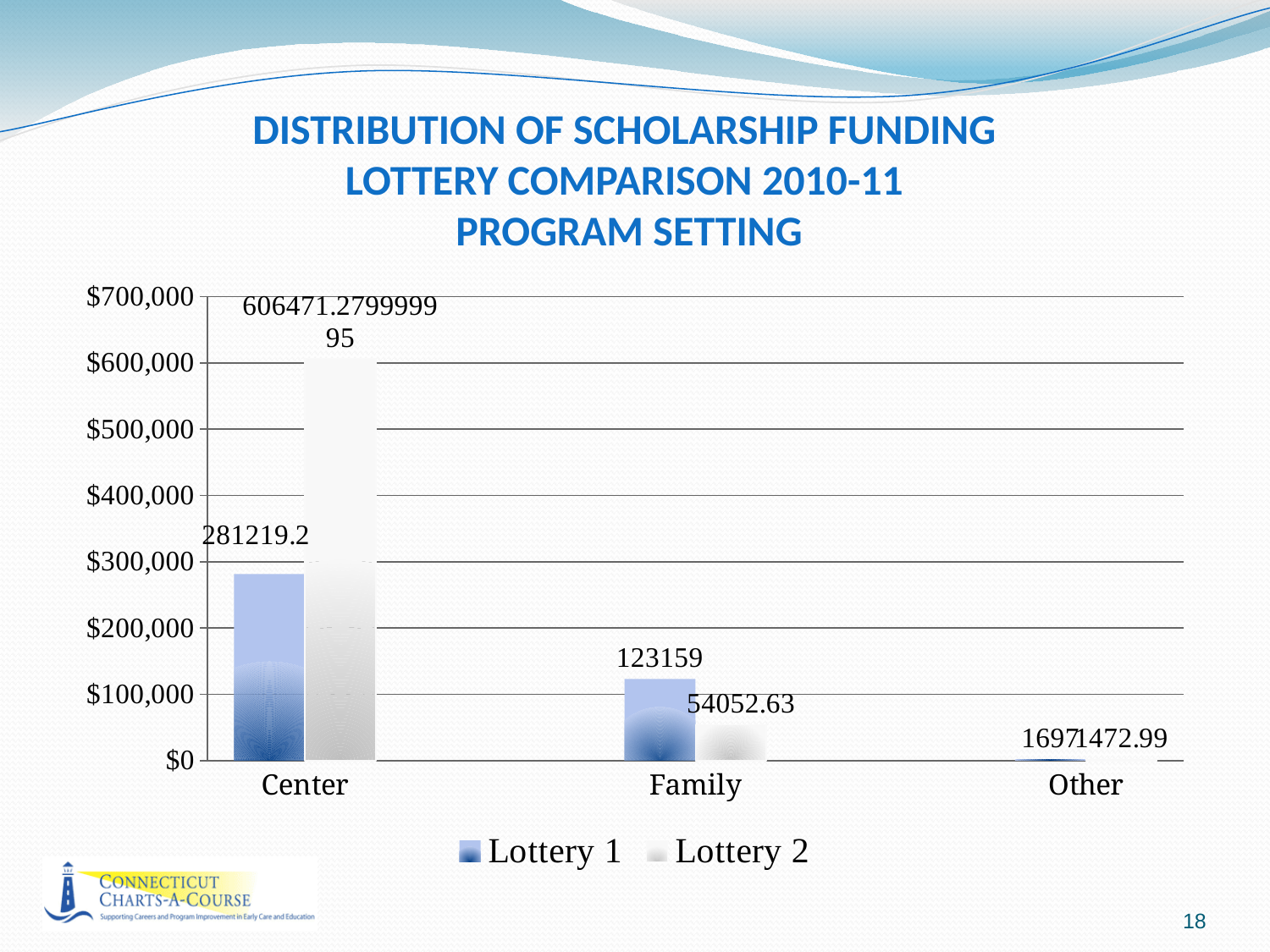
Which category has the lowest Lottery 1 value? Other What is the Lottery 1 value for Family? 123159 What is the Lottery 1 value for Center? 281219.2 How many series does the legend list? 2 For Center, which is larger, Lottery 1 or Lottery 2? Lottery 2 What is the difference between the Lottery 1 and Lottery 2 values for Family? 69106.37 What type of chart is shown on the slide? bar chart What is the Lottery 2 value for Family? 54052.63 How many program setting categories are shown on the x axis? 3 Is the Lottery 2 value for Center greater or less than $600,000? greater Which category has the highest Lottery 2 value? Center For Family, which is larger, Lottery 1 or Lottery 2? Lottery 1